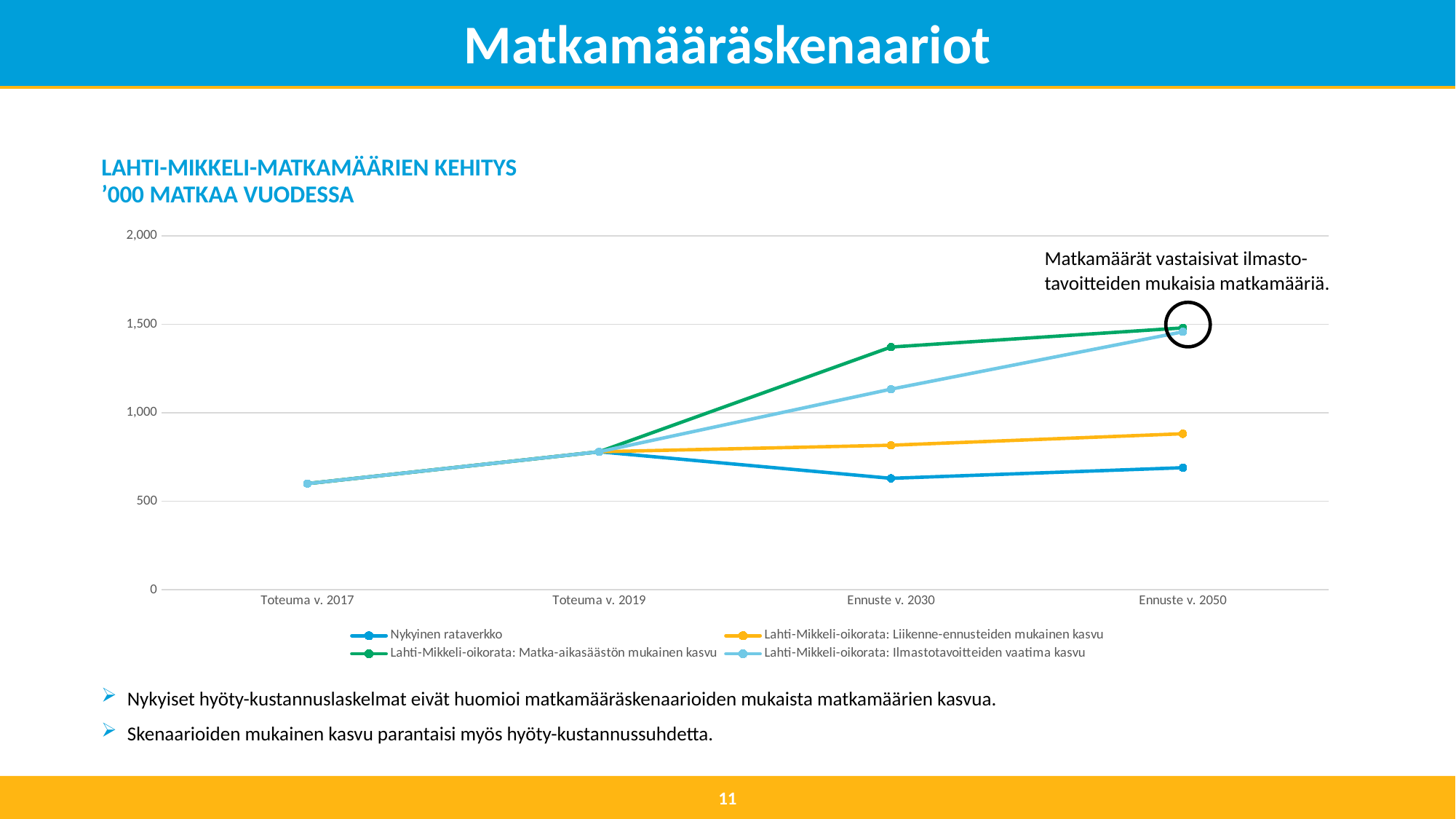
In what unit are the chart's values expressed, according to the subtitle? '000 matkaa vuodessa Which series has the lowest value at Ennuste v. 2050? Nykyinen rataverkko Is the value for Lahti-Mikkeli-oikorata: Matka-aikasäästön mukainen kasvu at Ennuste v. 2030 greater or less than 1,000? greater Is the value for Nykyinen rataverkko at Ennuste v. 2030 greater or less than 1,000? less Is the value at Toteuma v. 2017 greater or less than 1,000? less Does the Nykyinen rataverkko series rise or fall from Toteuma v. 2019 to Ennuste v. 2030? fall What kind of chart is shown on the slide? line chart How many points are there along the x axis of the chart? 4 How many series does the chart legend list? 4 What is the title of the chart? LAHTI-MIKKELI-MATKAMÄÄRIEN KEHITYS Which series has the highest value at Ennuste v. 2030? Lahti-Mikkeli-oikorata: Matka-aikasäästön mukainen kasvu